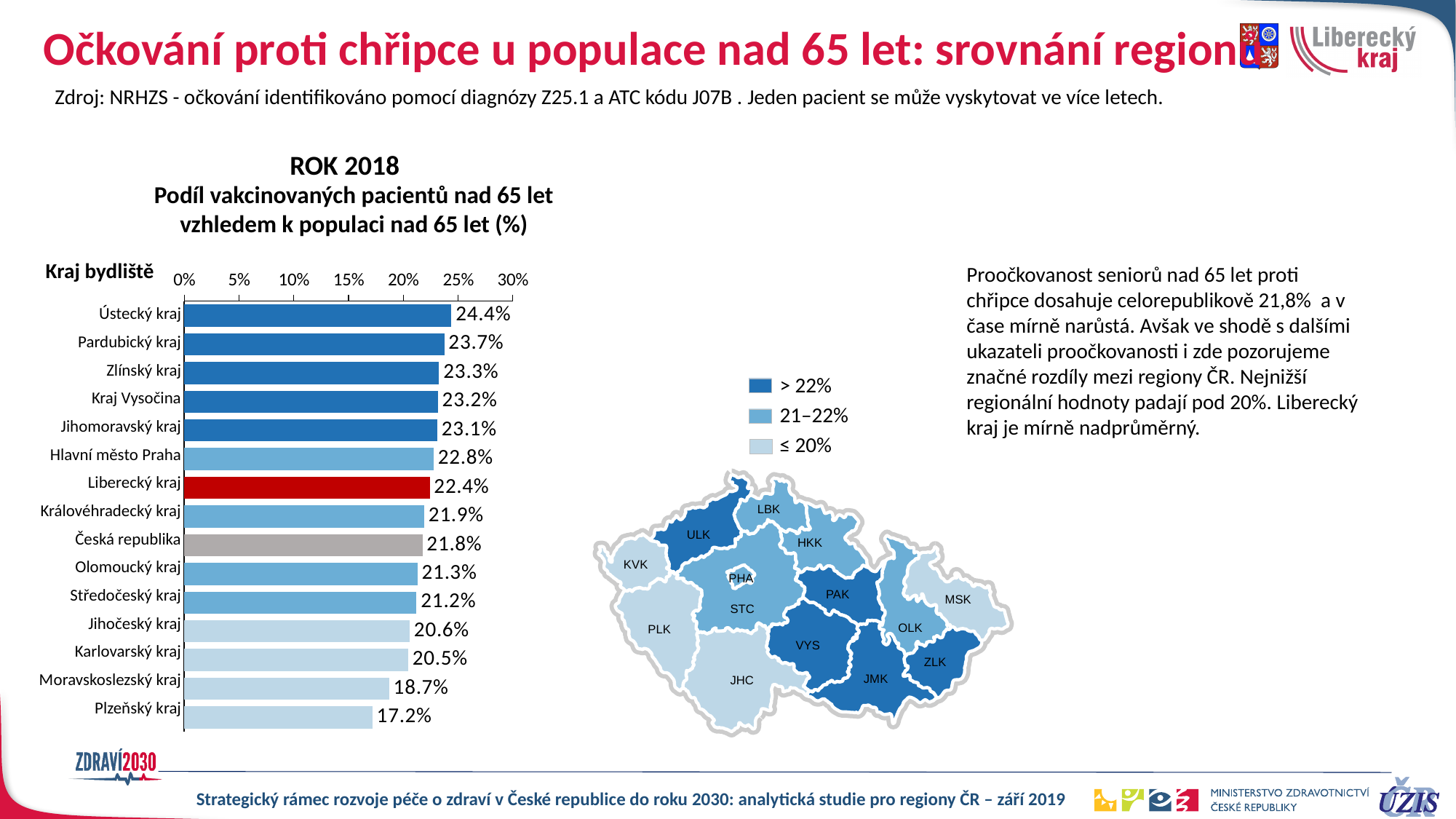
What kind of chart is shown on the left of the slide? bar chart What is the difference between the values for Liberecký kraj and Česká republika? 0.6 percentage points How many bars are shown in the bar chart? 15 Which year does the bar chart refer to, according to its title? 2018 What is the value for Moravskoslezský kraj in the bar chart? 18.7% Is the value for Plzeňský kraj greater or less than 20%? less Which region has the lowest value in the bar chart? Plzeňský kraj What is the value for Liberecký kraj in the bar chart? 22.4% What is the value for Česká republika in the bar chart? 21.8% Which has a larger value, Pardubický kraj or Jihočeský kraj? Pardubický kraj Which region has the highest value in the bar chart? Ústecký kraj What is the difference between the values for Ústecký kraj and Plzeňský kraj? 7.2 percentage points